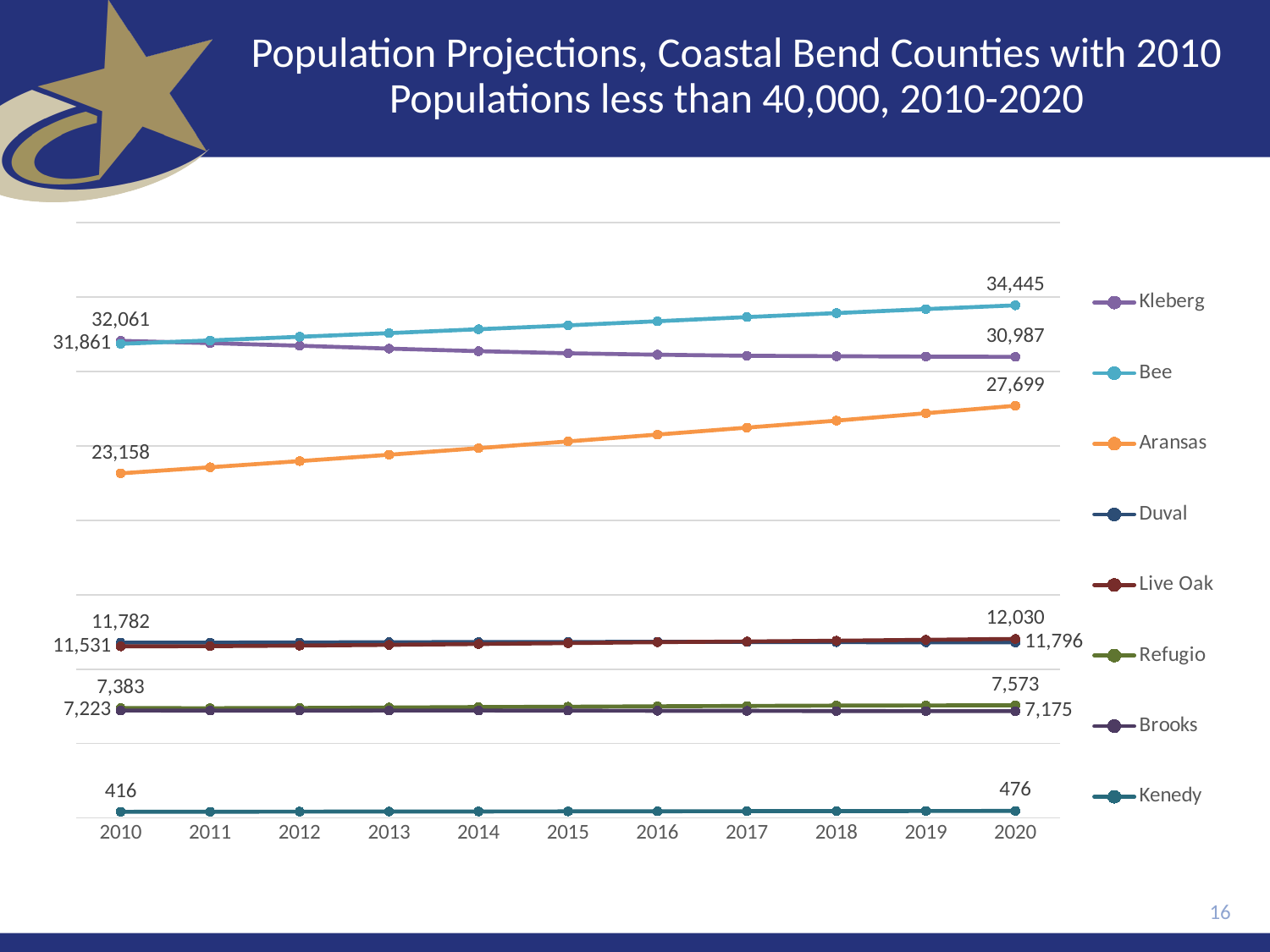
How many counties (series) does the legend list? 8 By how much is Aransas County's population projected to grow from 2010 to 2020? 4,541 Does the Bee County line rise or fall from 2010 to 2020? rises What is the projected population of Kenedy County in 2020? 476 What is the projected population of Bee County in 2020? 34,445 How many years are shown on the x axis? 11 What is the population of Kleberg County in 2010? 32,061 Which county has the lowest population across the chart? Kenedy Does the Kleberg County line rise or fall from 2010 to 2020? falls Which county has the highest projected population in 2020? Bee What is the population of Aransas County in 2010? 23,158 What kind of chart is shown on the slide? line chart